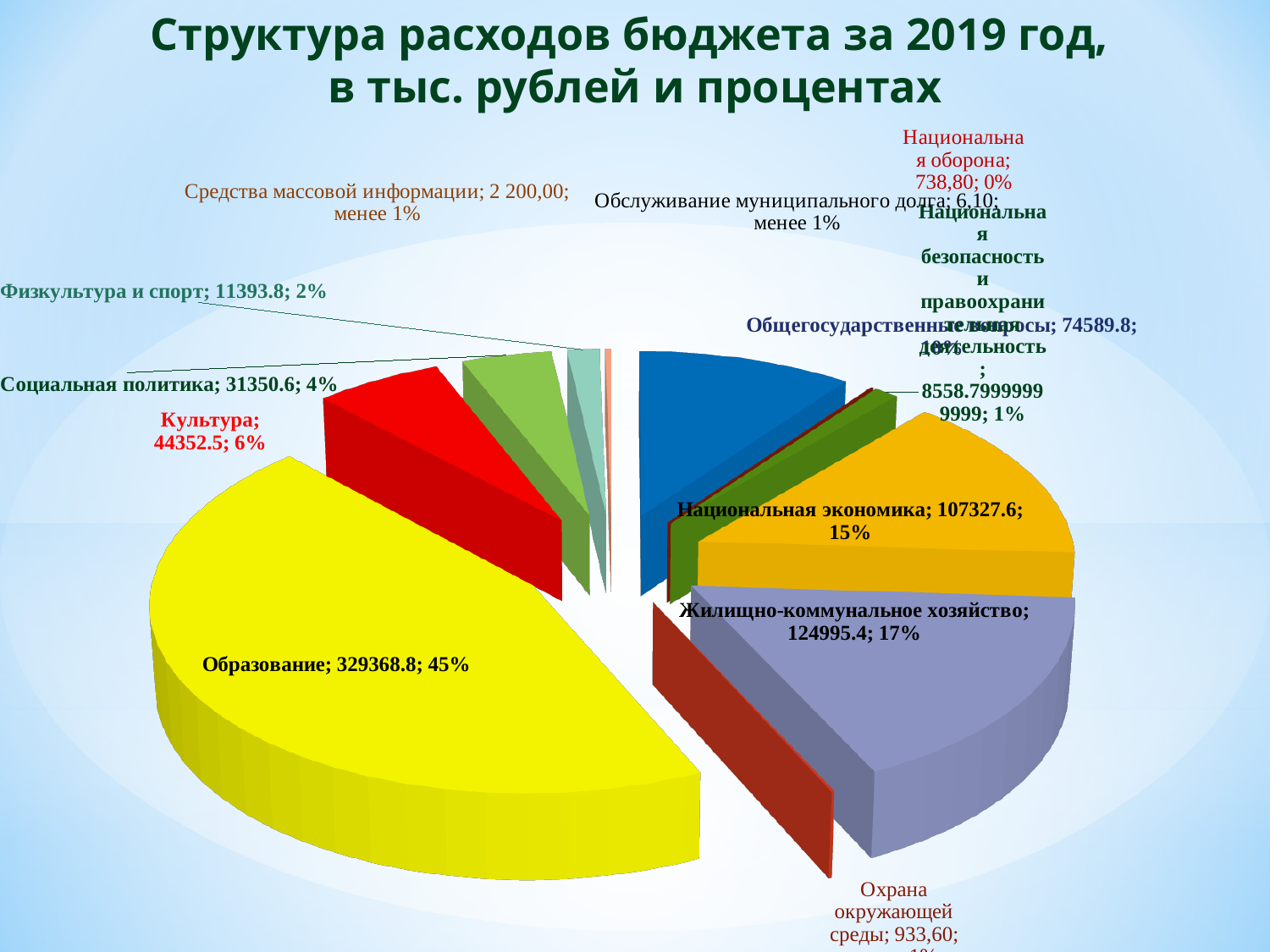
What kind of chart is shown on the slide? pie chart What share of the pie does Образование represent? 45% Which category has the largest slice of the pie? Образование What is the value shown for Физкультура и спорт? 11393.8 What is the value shown for Жилищно-коммунальное хозяйство? 124995.4 What is the value shown for Культура? 44352.5 What percentage is shown for Социальная политика? 4% What is the title of the chart? Структура расходов бюджета за 2019 год, в тыс. рублей и процентах What is the difference between the values for Образование and Жилищно-коммунальное хозяйство? 204373.4 Which is larger, Жилищно-коммунальное хозяйство or Национальная экономика? Жилищно-коммунальное хозяйство What is the value shown for Образование? 329368.8 What percentage is shown for Национальная экономика? 15%